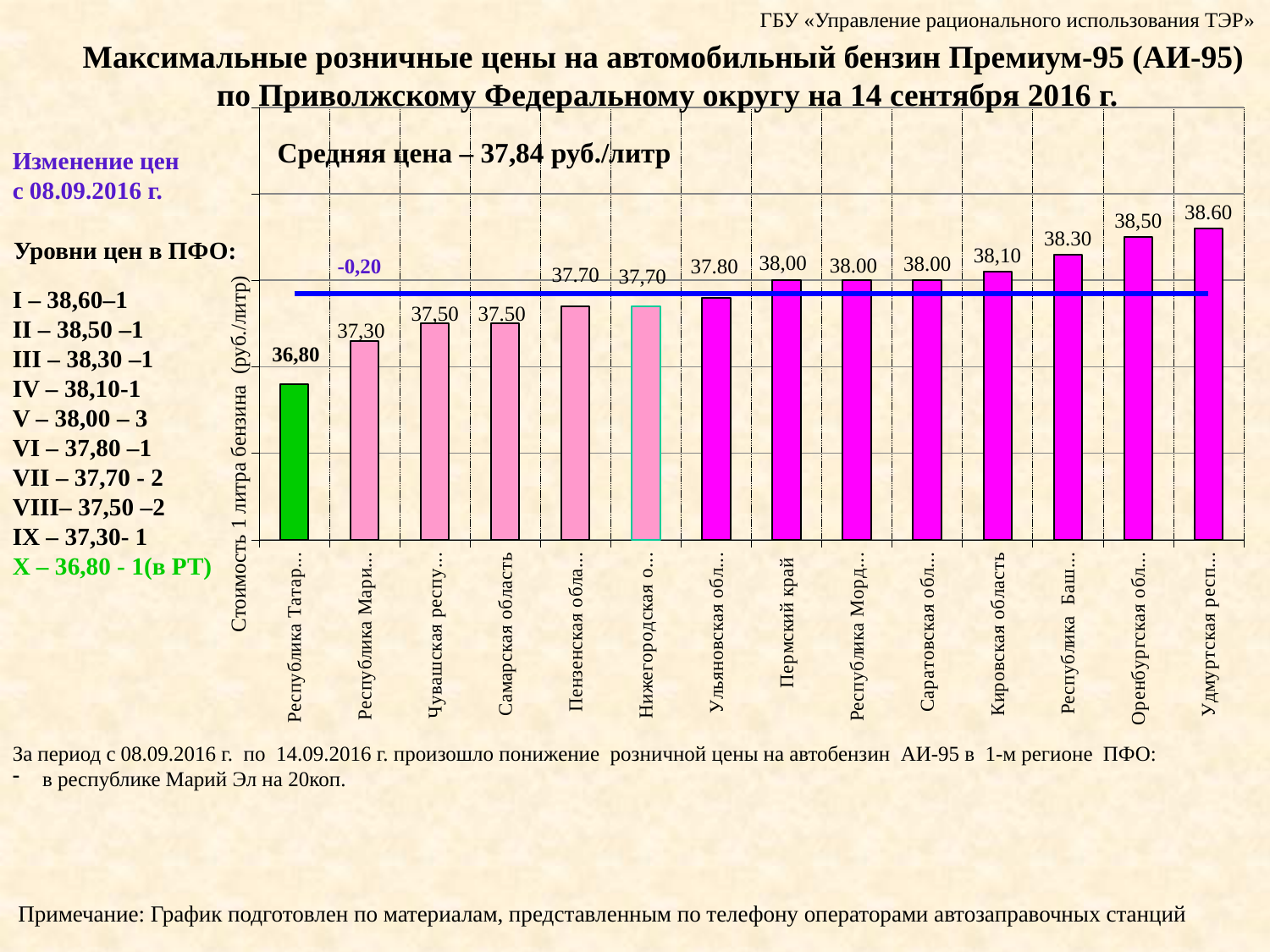
What is the value shown for Самарская область? 37.50 What is the value of the first (leftmost, green) bar in the chart? 36,80 What is the value shown for Кировская область? 38,10 What kind of chart is shown on the slide? bar chart Which is larger, the value for Пермский край or the value for Самарская область? Пермский край What average price (Средняя цена) is stated on the chart? 37,84 руб./литр What is the value shown for Пермский край? 38,00 Which bar has the lowest value in the chart? Республика Татар... (the first, green bar) What is the difference between the values for Кировская область and Самарская область? 0,60 How many regions (bars) are plotted in the chart? 14 Which bar has the highest value in the chart? Удмуртская респ... (the last bar) What is the value of the last (rightmost) bar in the chart? 38.60